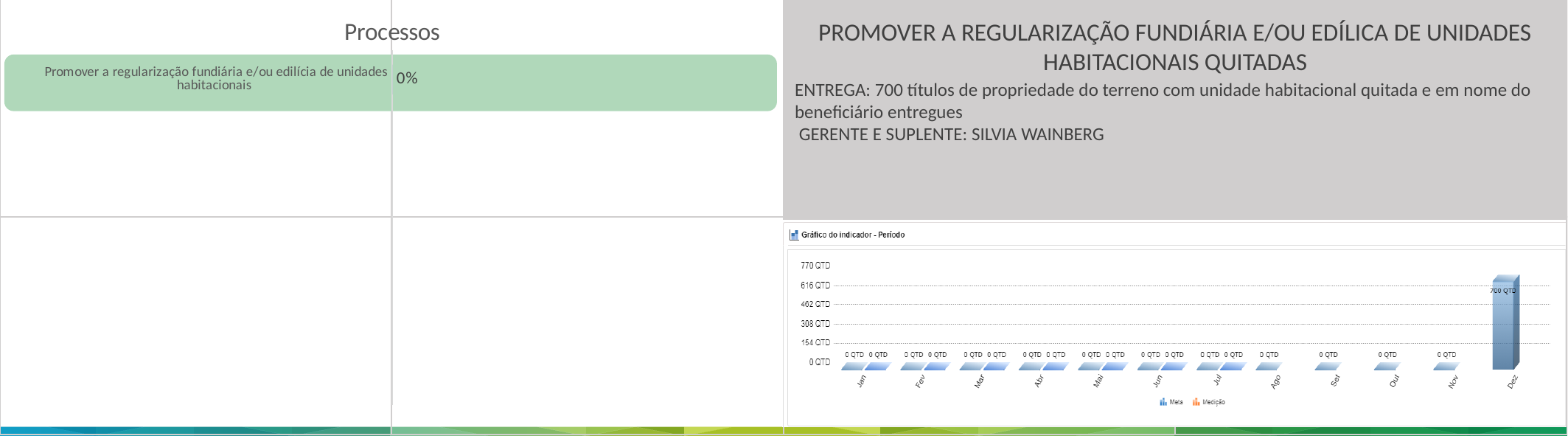
Is the Meta value for Dez greater or less than 616 QTD? greater Which is larger, the Meta value for Dez or the Meta value for Jun? Dez What is the chart's title? Gráfico do indicador - Período What is the Meta value for Jan in the chart? 0 QTD What is the Meta value for Dez in the chart? 700 QTD What is the Medição value for Mar in the chart? 0 QTD How many series does the chart legend list? 2 What type of chart is shown under 'Gráfico do indicador - Período'? bar chart Which month has the highest Meta value in the chart? Dez What are the two series named in the chart legend? Meta and Medição How many months are shown on the x axis of the chart? 12 What is the difference between the Meta value for Dez and the Meta value for Nov? 700 QTD